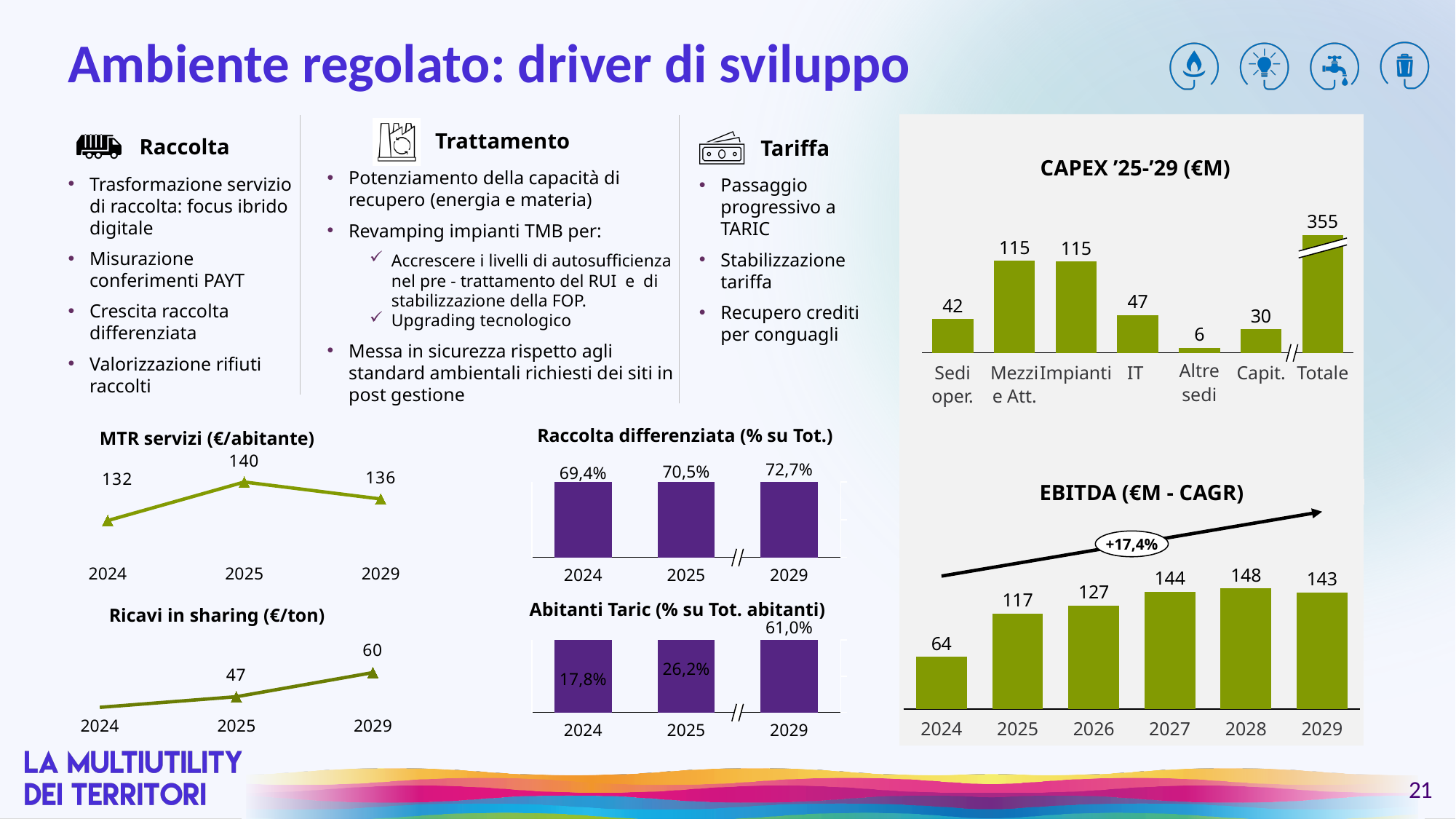
In the MTR servizi (€/abitante) chart, what is the value for 2025? 140 In the CAPEX '25-'29 (€M) chart, which category has the lowest value? Altre sedi In the EBITDA (€M - CAGR) chart, which year has the highest value? 2028 In the Abitanti Taric (% su Tot. abitanti) chart, what is the value for 2029? 61,0% In the CAPEX '25-'29 (€M) chart, what is the value for Totale? 355 In the EBITDA (€M - CAGR) chart, what is the value for 2027? 144 In the CAPEX '25-'29 (€M) chart, what is the difference between Sedi oper. and Capit.? 12 In the CAPEX '25-'29 (€M) chart, what is the value for IT? 47 In the EBITDA (€M - CAGR) chart, how many years are plotted? 6 What kind of chart is the Ricavi in sharing (€/ton) chart? Line chart In the EBITDA (€M - CAGR) chart, what CAGR is shown on the arrow? +17,4% In the Ricavi in sharing (€/ton) chart, do the values rise or fall from 2024 to 2029? Rise